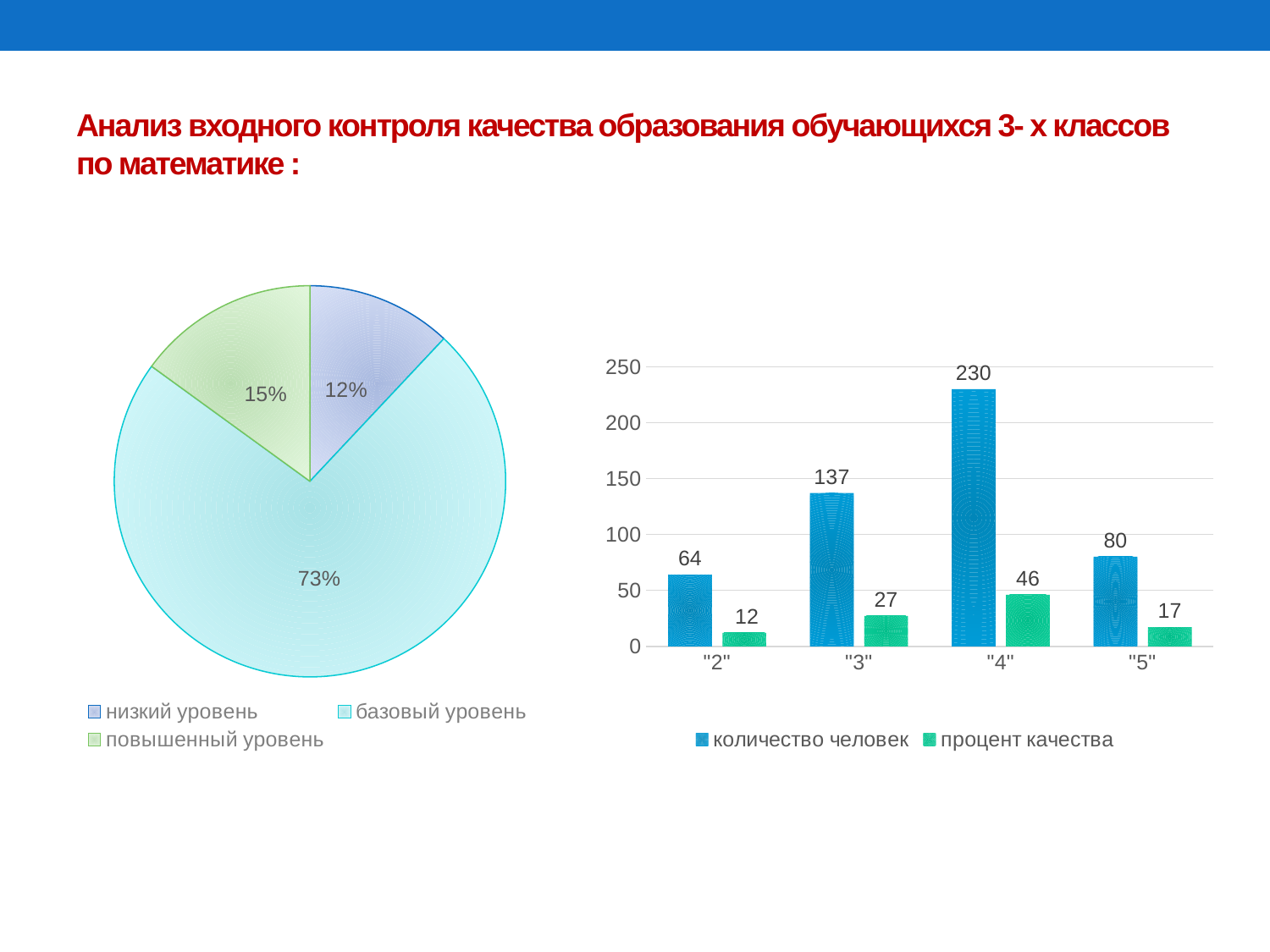
In the bar chart on the right, what is the difference between "количество человек" for "3" and for "5"? 57 In the bar chart on the right, what is the value of "количество человек" for "4"? 230 In the pie chart on the left, what share does "базовый уровень" have? 73% In the bar chart on the right, which category has the highest value for "количество человек"? "4" What kind of chart is shown on the right side of the slide? bar chart In the pie chart on the left, how many categories does the legend list? 3 In the pie chart on the left, what share does "низкий уровень" have? 12% In the bar chart on the right, which category has the lowest value for "процент качества"? "2" In the pie chart on the left, which category has the largest slice? базовый уровень In the pie chart on the left, which category has the smallest slice? низкий уровень In the bar chart on the right, how many series does the legend list? 2 In the bar chart on the right, what is the value of "процент качества" for "3"? 27